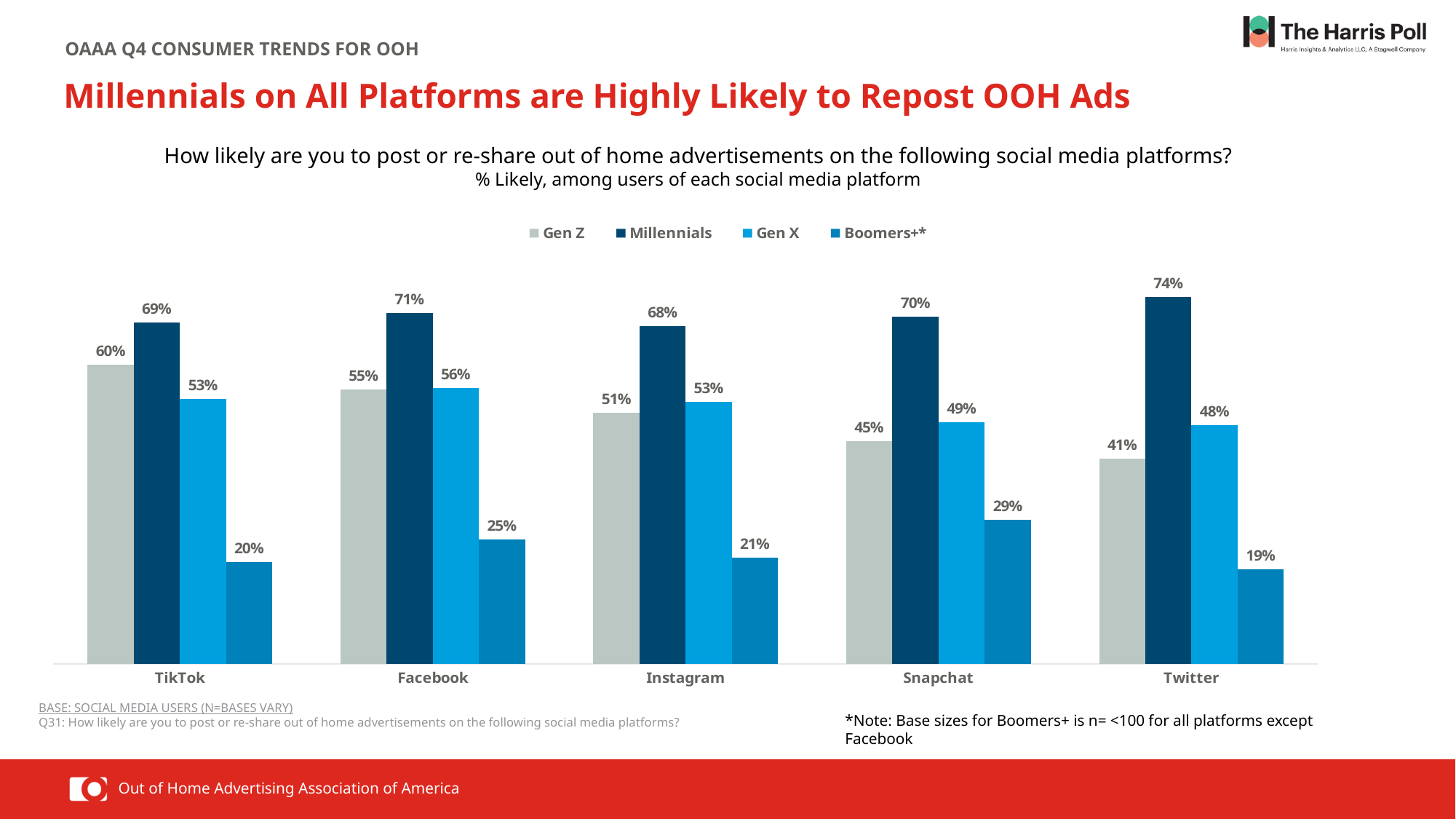
What percentage of Millennials are likely to repost OOH ads on Twitter? 74% On which platform is the Millennials value highest? Twitter What is the value for Gen Z on Instagram? 51% Which is larger on Snapchat: the Gen Z value or the Gen X value? Gen X Which generation is represented by the dark navy bars? Millennials What is the difference between the Gen Z and Boomers+ values for TikTok? 40% How many social media platforms are shown on the x axis? 5 How many series does the legend list? 4 What is the difference between the Millennials and Gen X values for Instagram? 15% What is the value for Boomers+ on Facebook? 25% What kind of chart is shown on the slide? Bar chart On which platform is the Boomers+ value lowest? Twitter